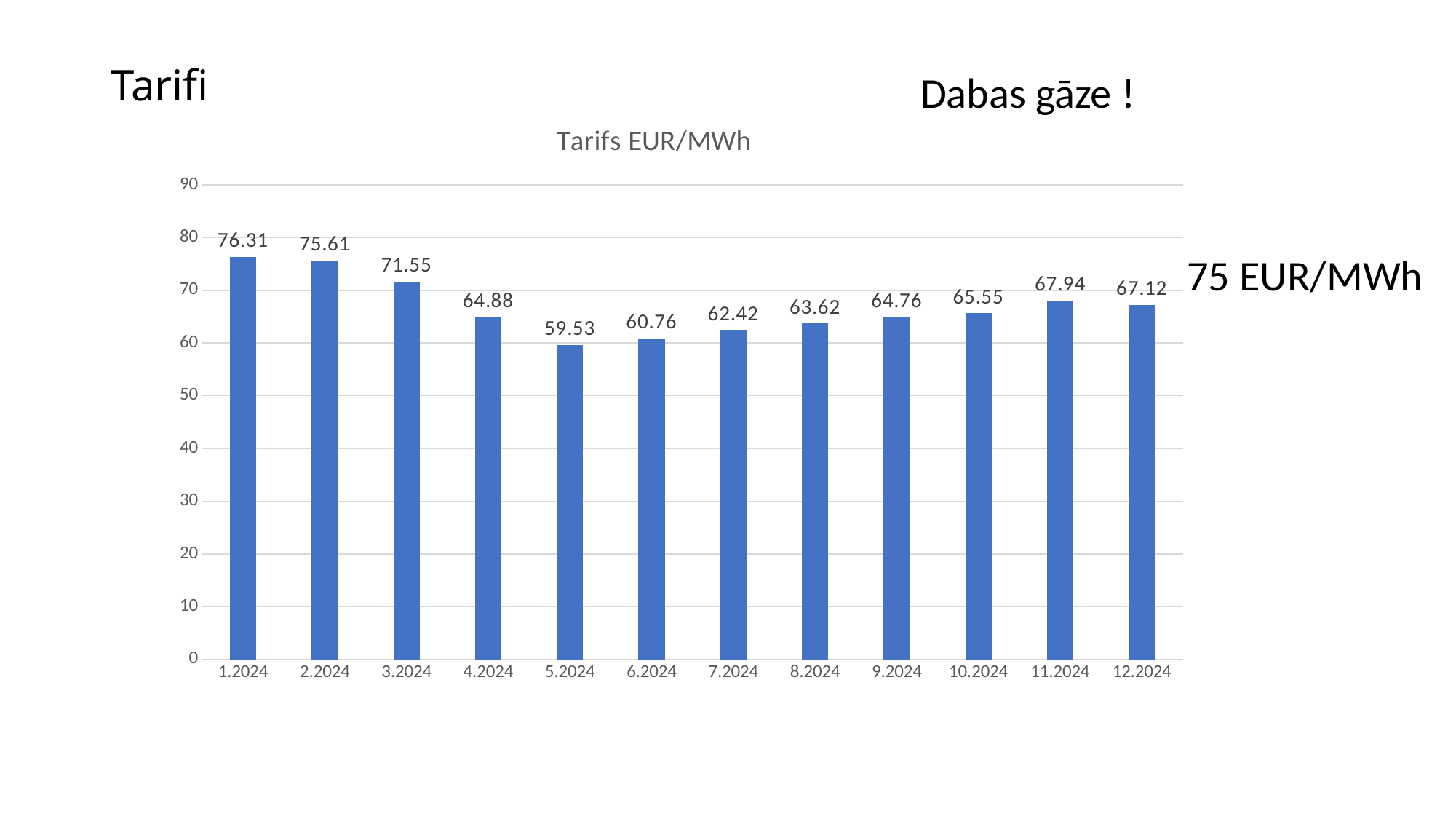
Which month has the highest value in the Tarifs EUR/MWh chart? 1.2024 Do the values in the Tarifs EUR/MWh chart rise or fall from 5.2024 to 11.2024? rise Which month has the lowest value in the Tarifs EUR/MWh chart? 5.2024 Is the value for 8.2024 in the Tarifs EUR/MWh chart greater or less than 70? less What is the value for 1.2024 in the Tarifs EUR/MWh chart? 76.31 Which is larger in the Tarifs EUR/MWh chart, the value for 3.2024 or the value for 12.2024? 3.2024 What kind of chart is the Tarifs EUR/MWh chart? bar chart What is the value for 11.2024 in the Tarifs EUR/MWh chart? 67.94 What is the value for 5.2024 in the Tarifs EUR/MWh chart? 59.53 What is the difference between the values for 1.2024 and 5.2024 in the Tarifs EUR/MWh chart? 16.78 How many months are shown on the x axis of the Tarifs EUR/MWh chart? 12 What is the title of the chart on the slide? Tarifs EUR/MWh